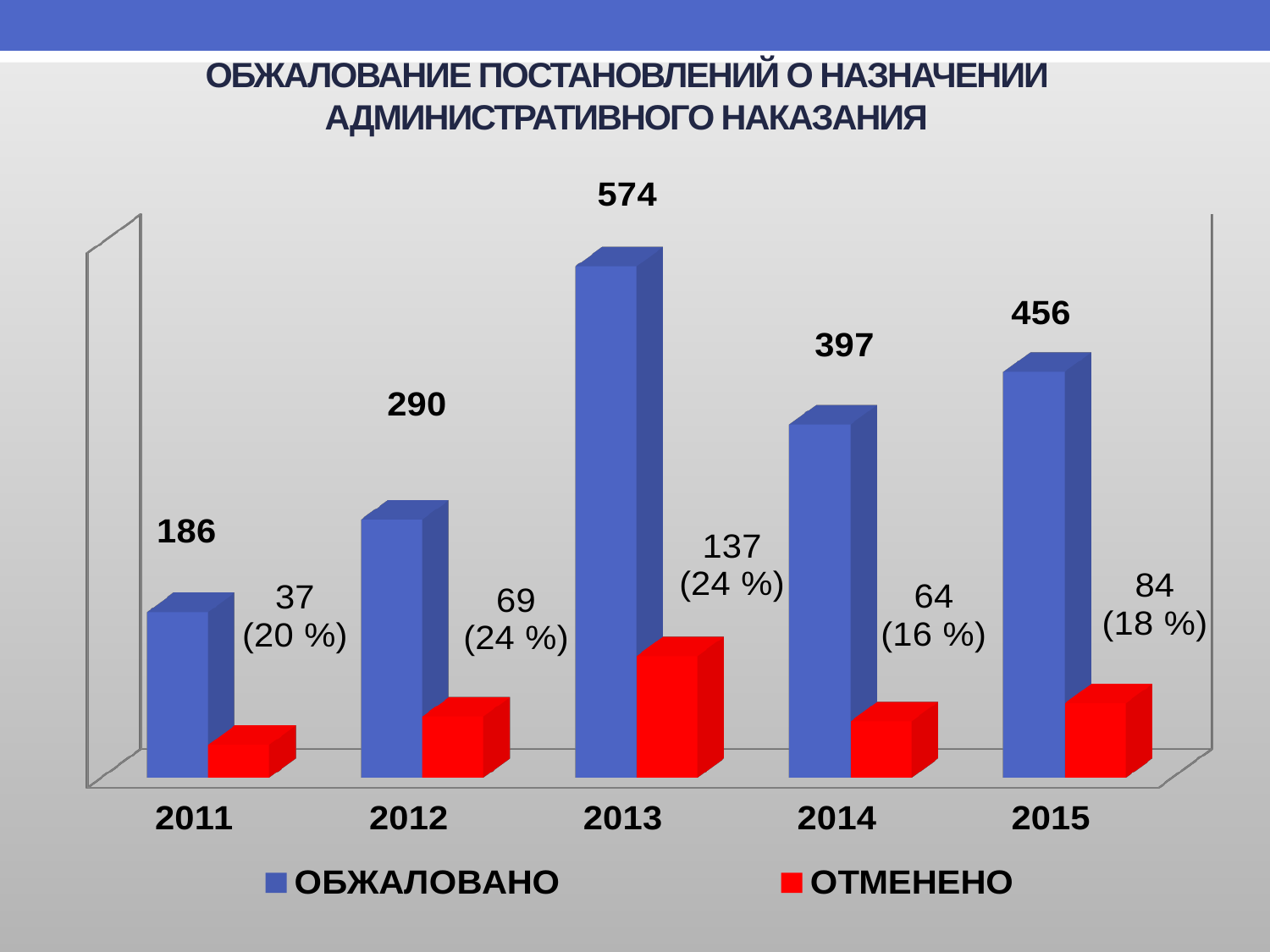
Which is larger: the ОБЖАЛОВАНО value for 2014 or for 2015? 2015 In which year is the ОБЖАЛОВАНО value highest? 2013 In which year is the ОТМЕНЕНО value lowest? 2011 What kind of chart is shown on the slide? bar chart What is the difference between the ОБЖАЛОВАНО values for 2013 and 2012? 284 Which colour represents the ОТМЕНЕНО series? red What is the value for ОБЖАЛОВАНО in 2015? 456 How many years are shown on the x axis? 5 What is the value for ОБЖАЛОВАНО in 2013? 574 What percentage is shown next to the ОТМЕНЕНО value for 2014? 16 % What is the value for ОТМЕНЕНО in 2011? 37 How many series does the legend list? 2